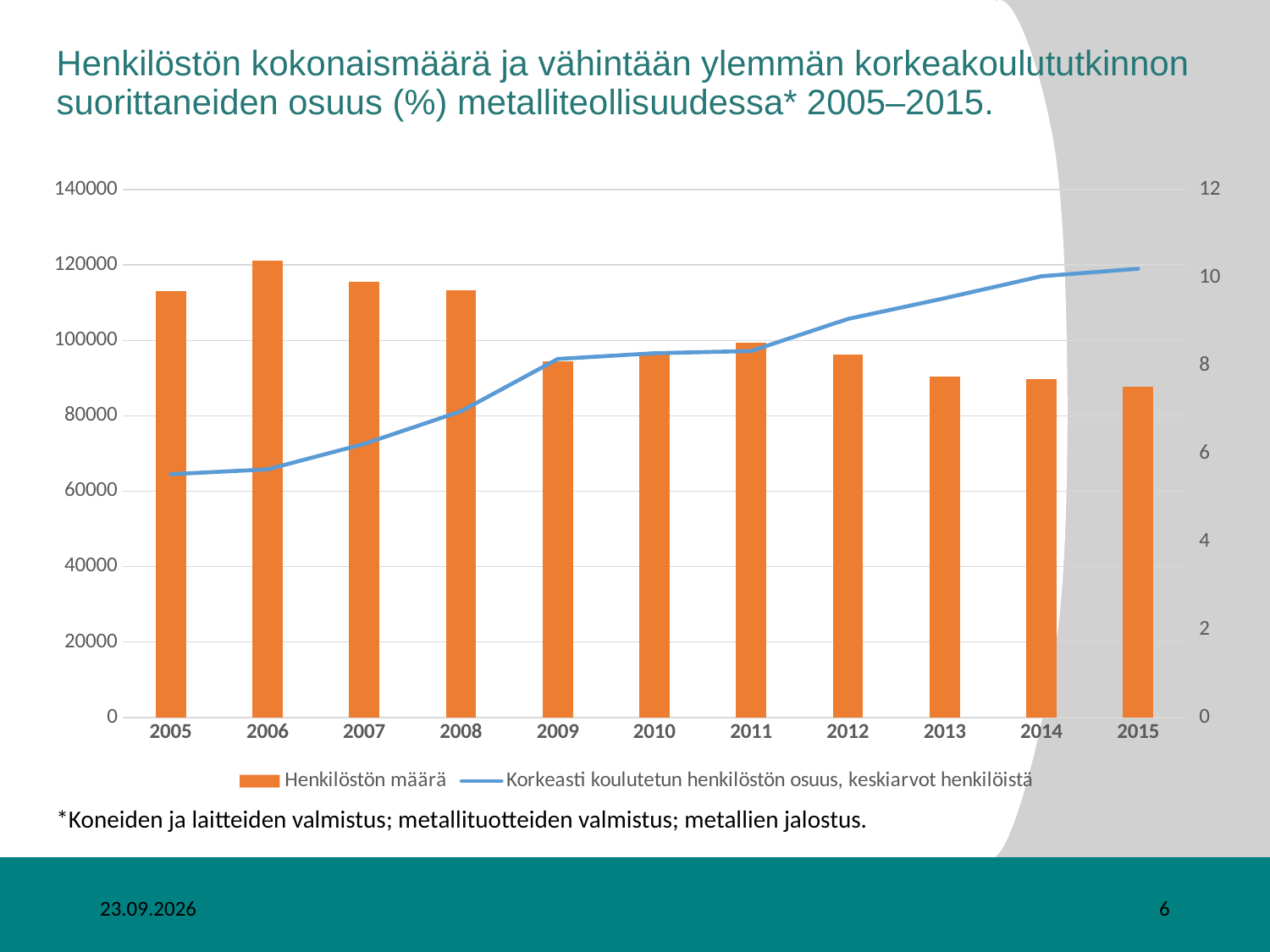
How many years are shown on the x axis? 11 Does the line for Korkeasti koulutetun henkilöstön osuus rise or fall from 2005 to 2015? rise Is the value for Korkeasti koulutetun henkilöstön osuus in 2005 greater or less than 6? less Is the value for Henkilöstön määrä in 2005 greater or less than 100000? greater Which year has the lowest value for Henkilöstön määrä? 2015 Which is larger, Henkilöstön määrä in 2006 or in 2012? 2006 Which year has the highest value for Henkilöstön määrä? 2006 Is the value for Henkilöstön määrä in 2009 greater or less than 100000? less How many series does the legend list? 2 What kind of chart is this? Combined bar and line chart